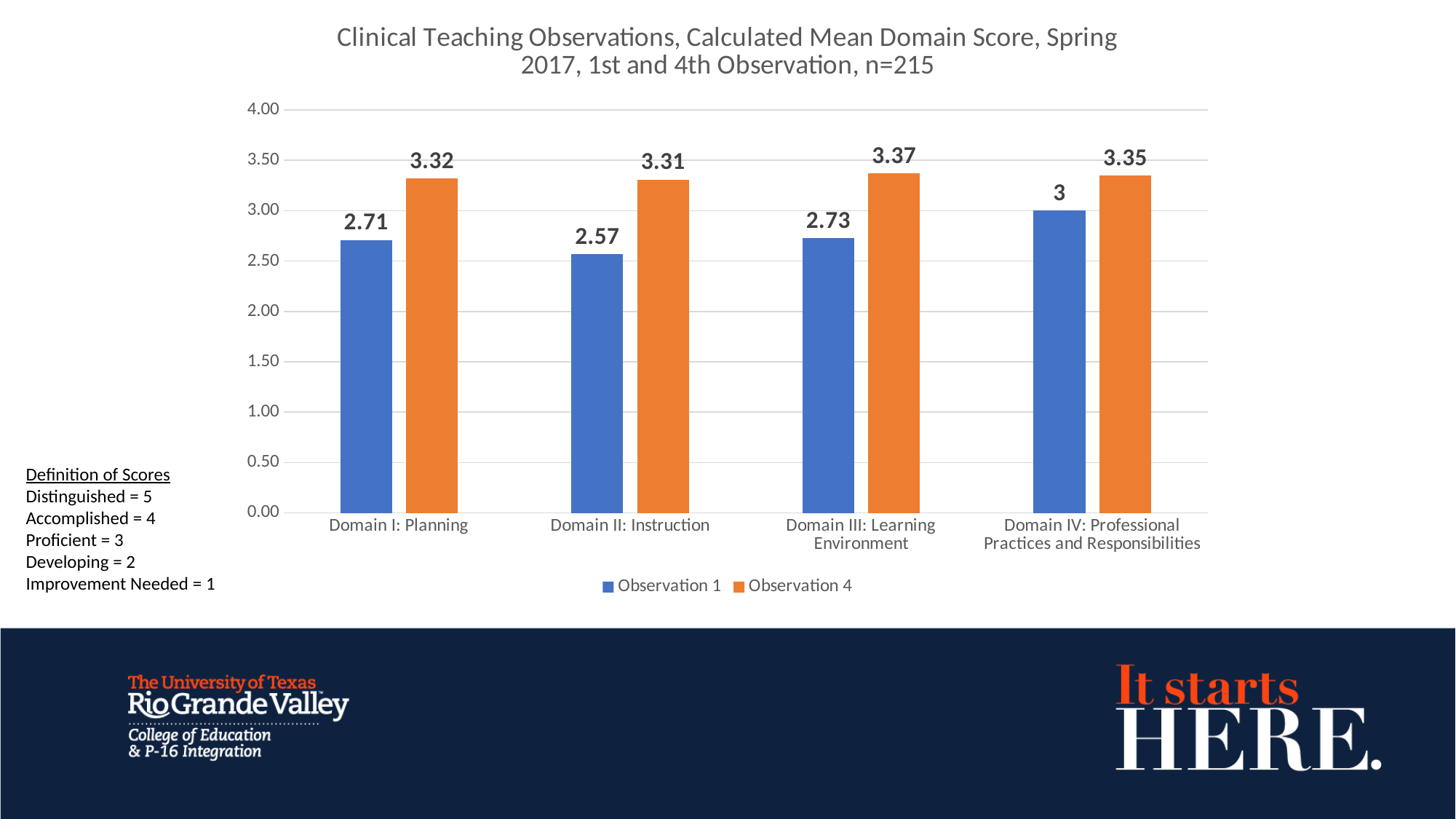
Is the Observation 1 value for Domain III: Learning Environment greater or less than 3.00? less Which domain has the highest Observation 1 value? Domain IV: Professional Practices and Responsibilities What kind of chart is shown on the slide? bar chart Which colour represents Observation 4 in the chart? orange What is the Observation 1 value for Domain I: Planning? 2.71 How many series does the legend list? 2 Which is larger for Domain I: Planning, the Observation 1 value or the Observation 4 value? Observation 4 What is the Observation 4 value for Domain III: Learning Environment? 3.37 What is the difference between the Observation 4 and Observation 1 values for Domain II: Instruction? 0.74 What is the Observation 1 value for Domain IV: Professional Practices and Responsibilities? 3 How many domains are shown on the x axis? 4 Which domain has the lowest Observation 1 value? Domain II: Instruction